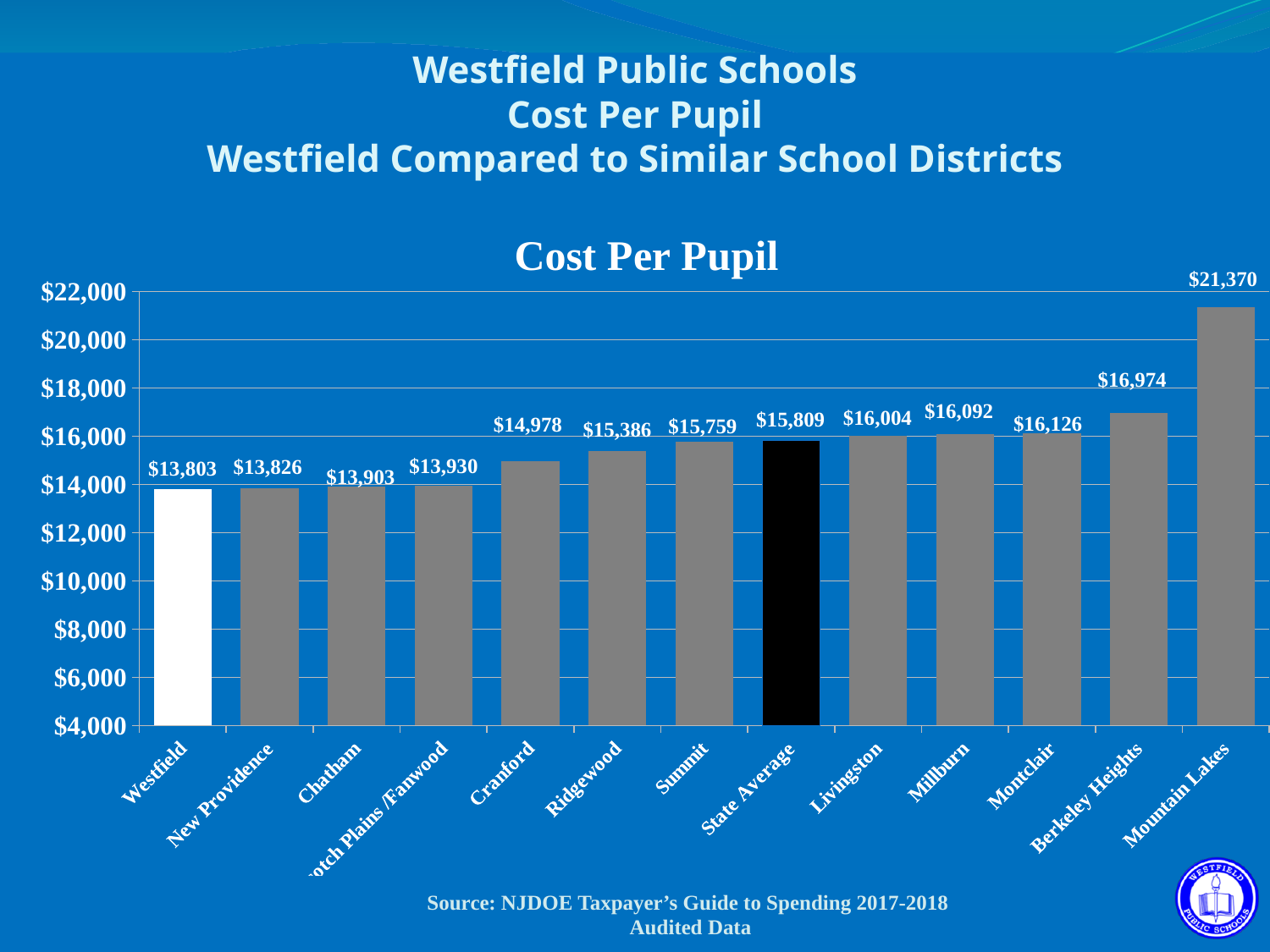
What is the difference in cost per pupil between Mountain Lakes and Westfield? $7,567 Is the cost per pupil for Ridgewood greater or less than $16,000? less Which district has the lowest cost per pupil? Westfield What is the difference between the State Average cost per pupil and Westfield's cost per pupil? $2,006 Which district has the highest cost per pupil? Mountain Lakes What is the State Average cost per pupil shown on the chart? $15,809 How many bars are plotted on the Cost Per Pupil chart? 13 What kind of chart is used to show cost per pupil? Bar chart Which has a higher cost per pupil, Cranford or Millburn? Millburn What is the cost per pupil for Mountain Lakes? $21,370 What is the cost per pupil for Berkeley Heights? $16,974 What is the cost per pupil for Westfield? $13,803